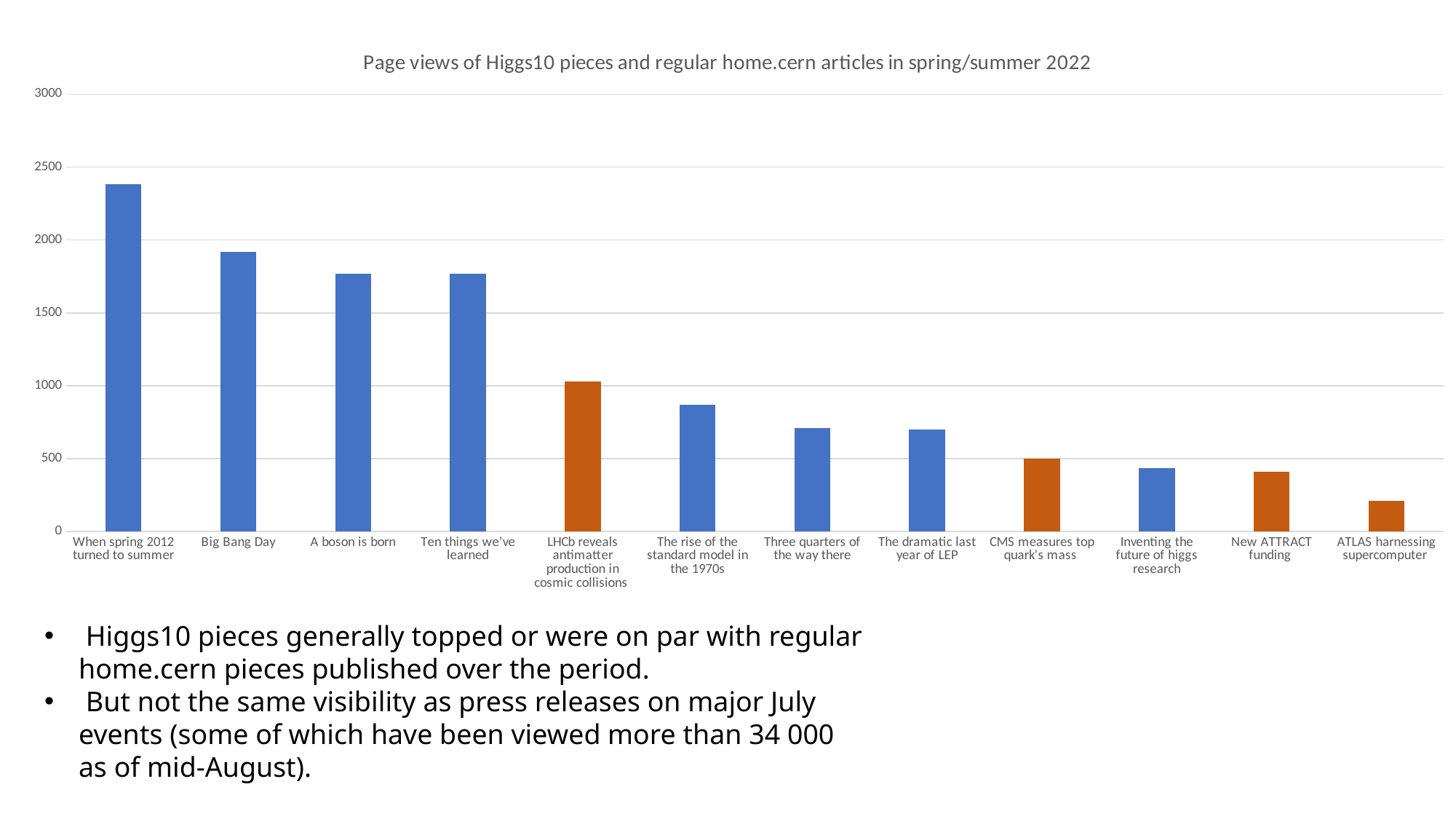
How many articles (categories) are plotted in the chart? 12 Which article has the highest number of page views? When spring 2012 turned to summer Is the value for "ATLAS harnessing supercomputer" greater or less than 500? less Do the bar values rise or fall from left to right along the x axis? fall Is the value for "The rise of the standard model in the 1970s" greater or less than 1000? less Is the value for "When spring 2012 turned to summer" greater or less than 2000? greater Which has more page views, "Big Bang Day" or "A boson is born"? Big Bang Day Which article has the lowest number of page views? ATLAS harnessing supercomputer Which has more page views, "LHCb reveals antimatter production in cosmic collisions" or "The rise of the standard model in the 1970s"? LHCb reveals antimatter production in cosmic collisions What kind of chart is shown on the slide? bar chart What is the title of the chart? Page views of Higgs10 pieces and regular home.cern articles in spring/summer 2022